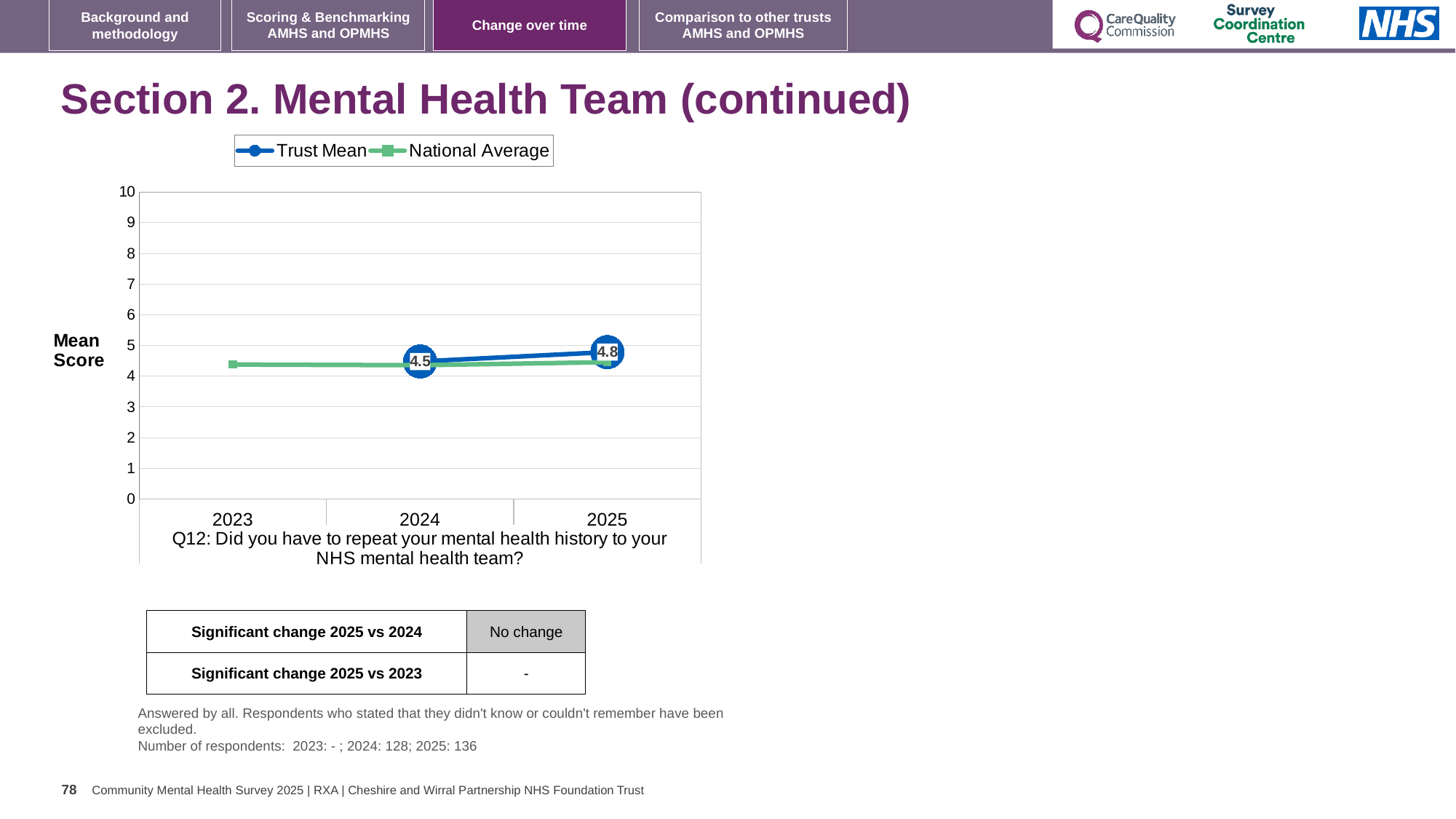
By how much did the Trust Mean change from 2024 to 2025? 0.3 How many series does the legend list? 2 What kind of chart is shown on the slide? line chart Does the Trust Mean rise or fall from 2024 to 2025? rise What are the two series named in the legend? Trust Mean and National Average What is the Trust Mean value for 2024? 4.5 What is the Trust Mean value for 2025? 4.8 Is the Trust Mean value for 2025 greater or less than 4? greater Is the National Average value for 2023 greater or less than 5? less In which year is the Trust Mean highest? 2025 Which year has the higher Trust Mean, 2024 or 2025? 2025 How many years are shown on the x axis? 3